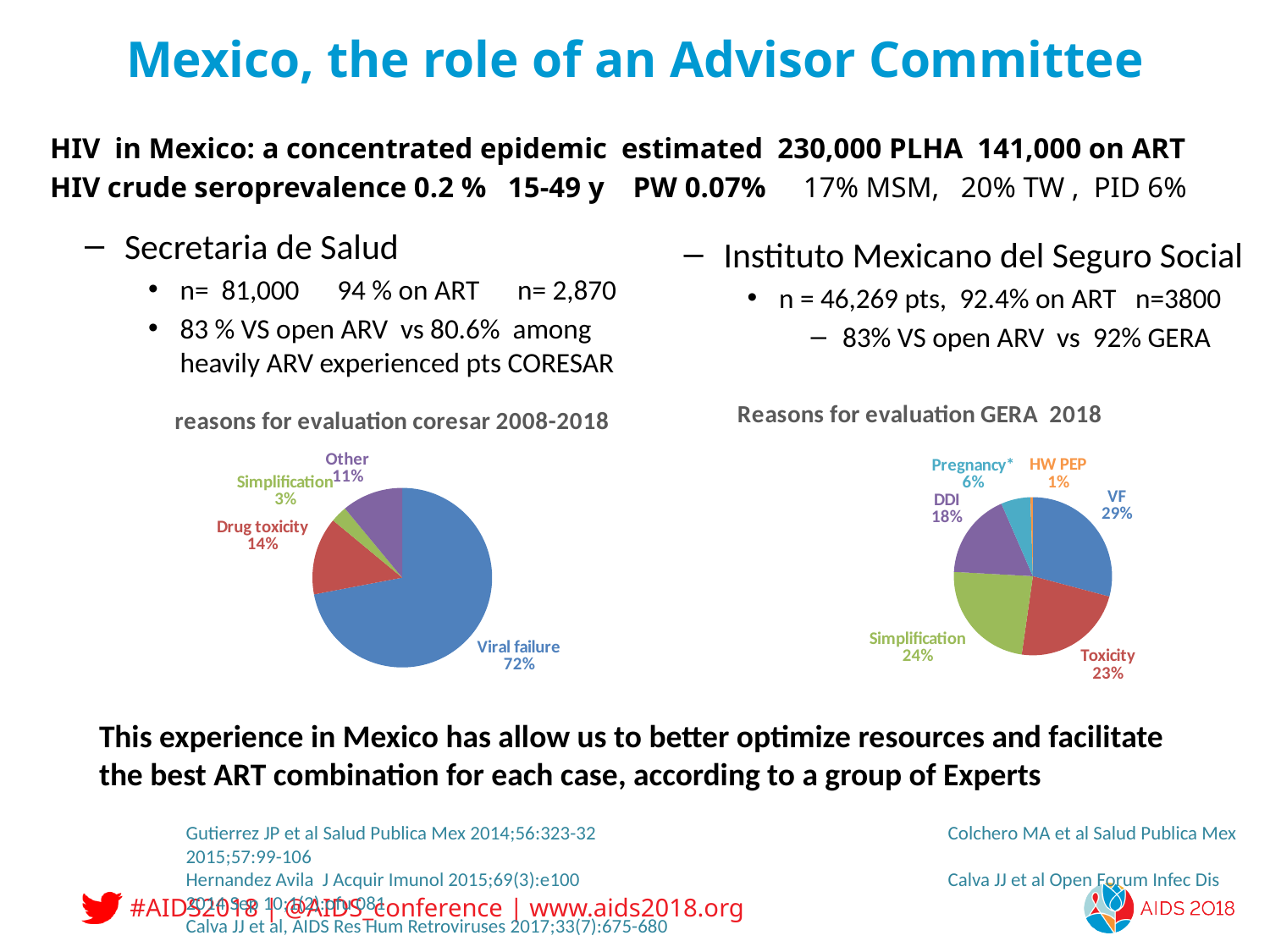
In the 'reasons for evaluation coresar 2008-2018' pie chart, what share is Drug toxicity? 14% In the 'Reasons for evaluation GERA 2018' pie chart, which category has the largest share? VF In the 'reasons for evaluation coresar 2008-2018' pie chart, what is the difference between the Viral failure and Other shares? 61% In the 'Reasons for evaluation GERA 2018' pie chart, which is larger, Toxicity or DDI? Toxicity What type of chart is used for 'Reasons for evaluation GERA 2018'? Pie chart In the 'Reasons for evaluation GERA 2018' pie chart, what share is DDI? 18% In the 'reasons for evaluation coresar 2008-2018' pie chart, how many slices are there? 4 In the 'reasons for evaluation coresar 2008-2018' pie chart, what share is Viral failure? 72% In the 'Reasons for evaluation GERA 2018' pie chart, how many categories are shown? 6 In the 'reasons for evaluation coresar 2008-2018' pie chart, which category has the smallest share? Simplification In the 'Reasons for evaluation GERA 2018' pie chart, what share is Simplification? 24% In the 'Reasons for evaluation GERA 2018' pie chart, which category has the smallest share? HW PEP